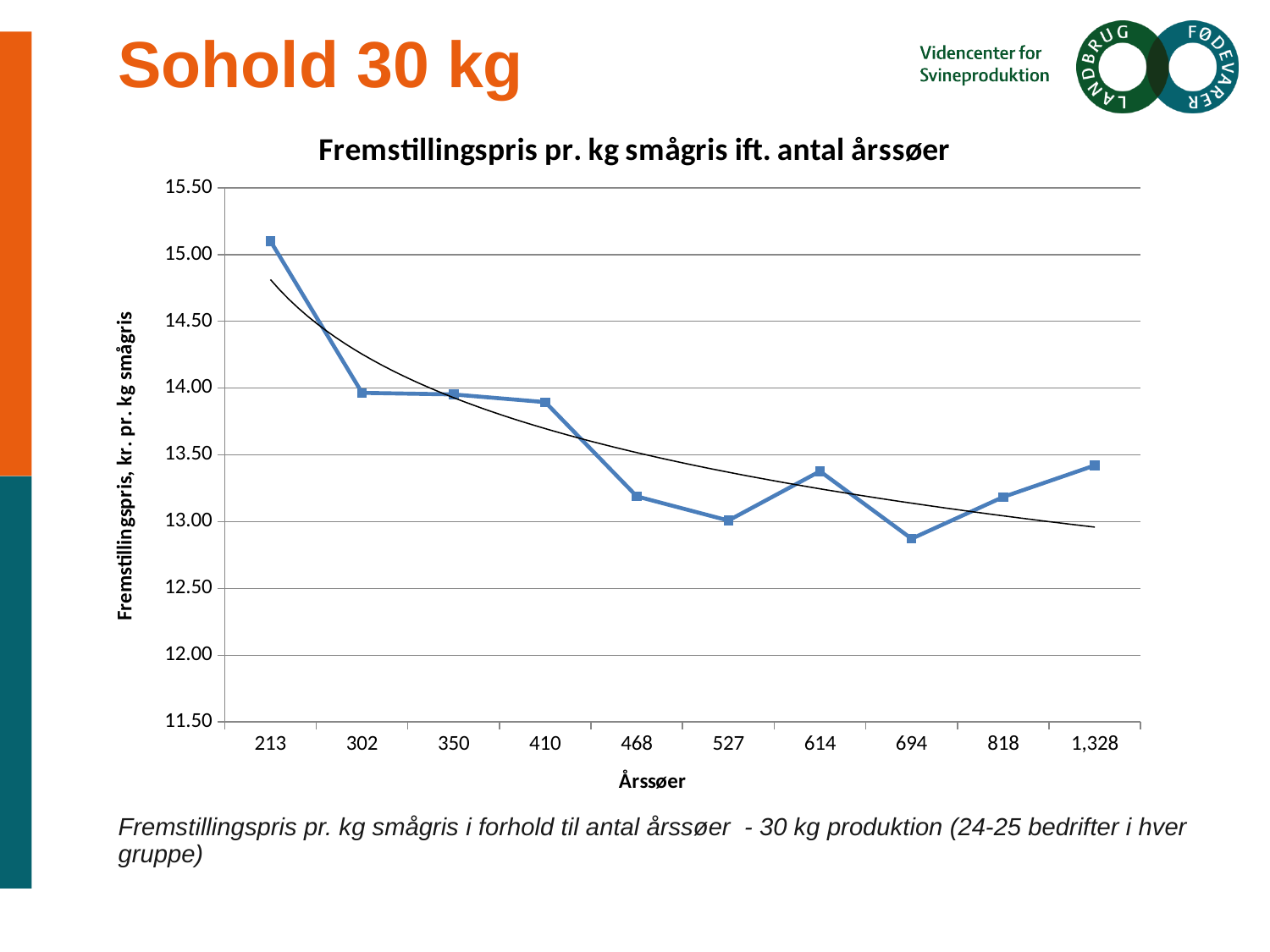
How many data points (årssøer categories) are plotted on the x axis? 10 What is the title of the chart? Fremstillingspris pr. kg smågris ift. antal årssøer Which årssøer category has the lowest fremstillingspris pr. kg smågris? 694 What kind of chart is shown on the slide? line chart Is the value for 213 årssøer greater or less than 15.00? greater Which has the higher fremstillingspris: 213 årssøer or 1,328 årssøer? 213 Which årssøer category has the highest fremstillingspris pr. kg smågris? 213 Overall, does the fremstillingspris rise or fall as the number of årssøer increases along the x axis? fall Is the value for 1,328 årssøer greater or less than 13.50? less Is the value for 468 årssøer greater or less than 13.00? greater Which has the higher fremstillingspris: 614 årssøer or 694 årssøer? 614